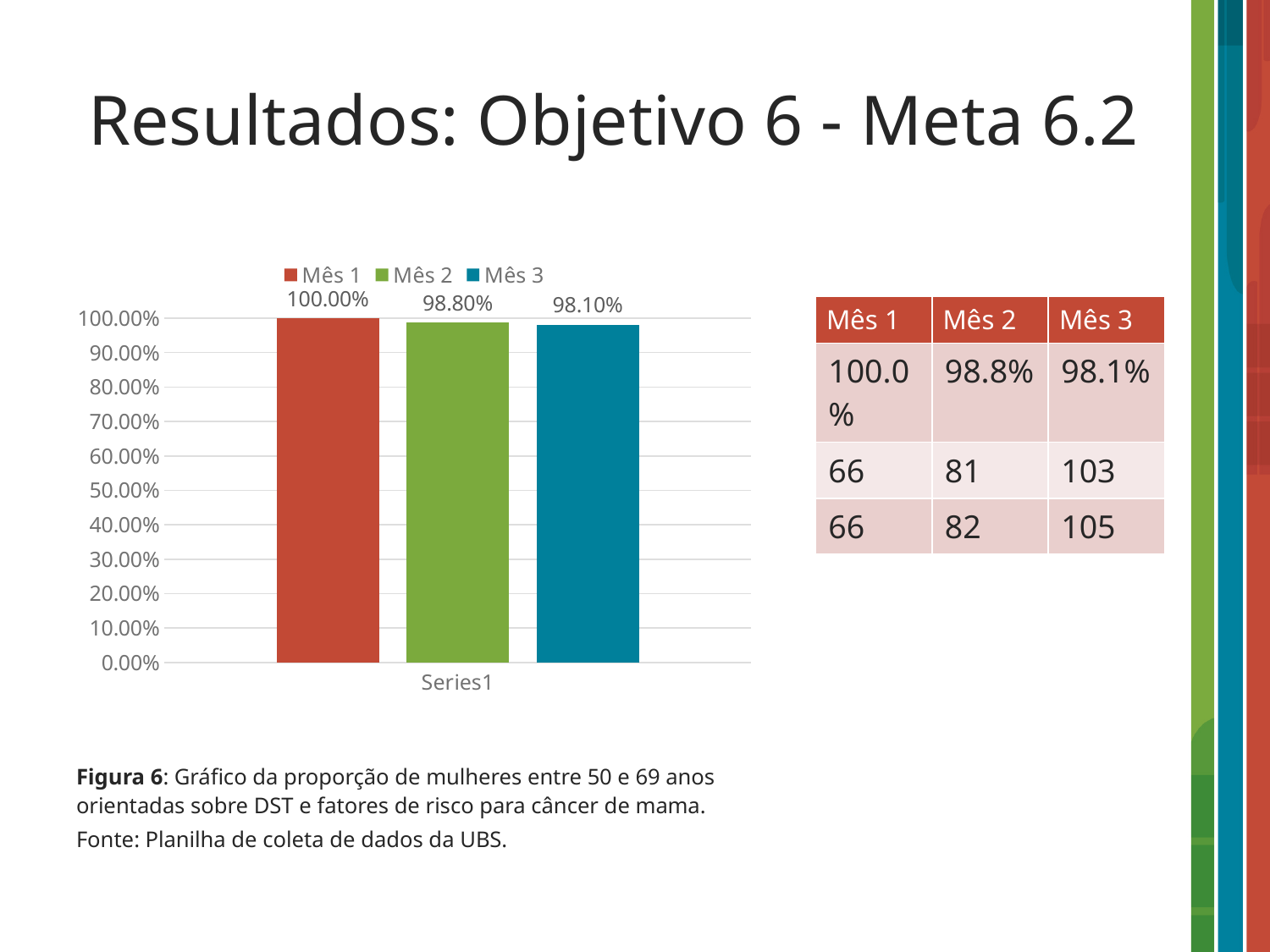
What colour is the bar for Mês 3? blue Which series has the highest value? Mês 1 How many series does the legend list? 3 What is the difference between the values for Mês 2 and Mês 3? 0.70% What is the value for Mês 2? 98.80% Which is larger, the value for Mês 1 or the value for Mês 2? Mês 1 What is the difference between the values for Mês 1 and Mês 3? 1.90% What is the value for Mês 1? 100.00% Is the value for Mês 3 greater or less than 90.00%? greater What is the value for Mês 3? 98.10% Which series has the lowest value? Mês 3 What kind of chart is shown? bar chart